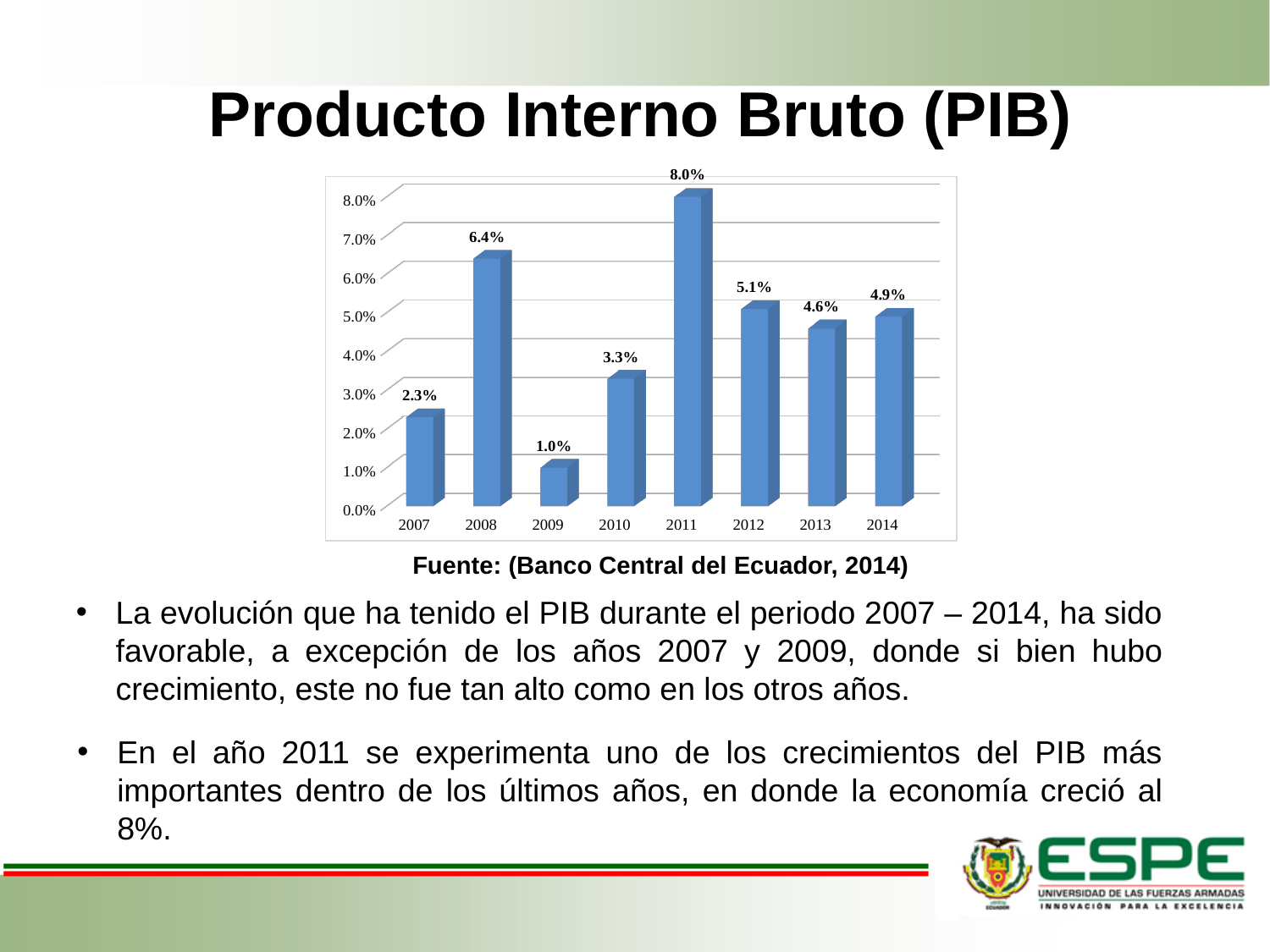
What is the value for 2009? 1.0% What is the difference between the values for 2011 and 2012? 2.9% How many years are shown on the x axis? 8 Which year has the highest value? 2011 Which is larger, the value for 2010 or the value for 2014? 2014 What kind of chart is shown on the slide? bar chart What is the value for 2011? 8.0% Which year has the lowest value? 2009 Is the value for 2012 greater or less than 5.0%? greater Do the values rise or fall from 2011 to 2013? fall What is the value for 2013? 4.6% What is the difference between the values for 2008 and 2007? 4.1%